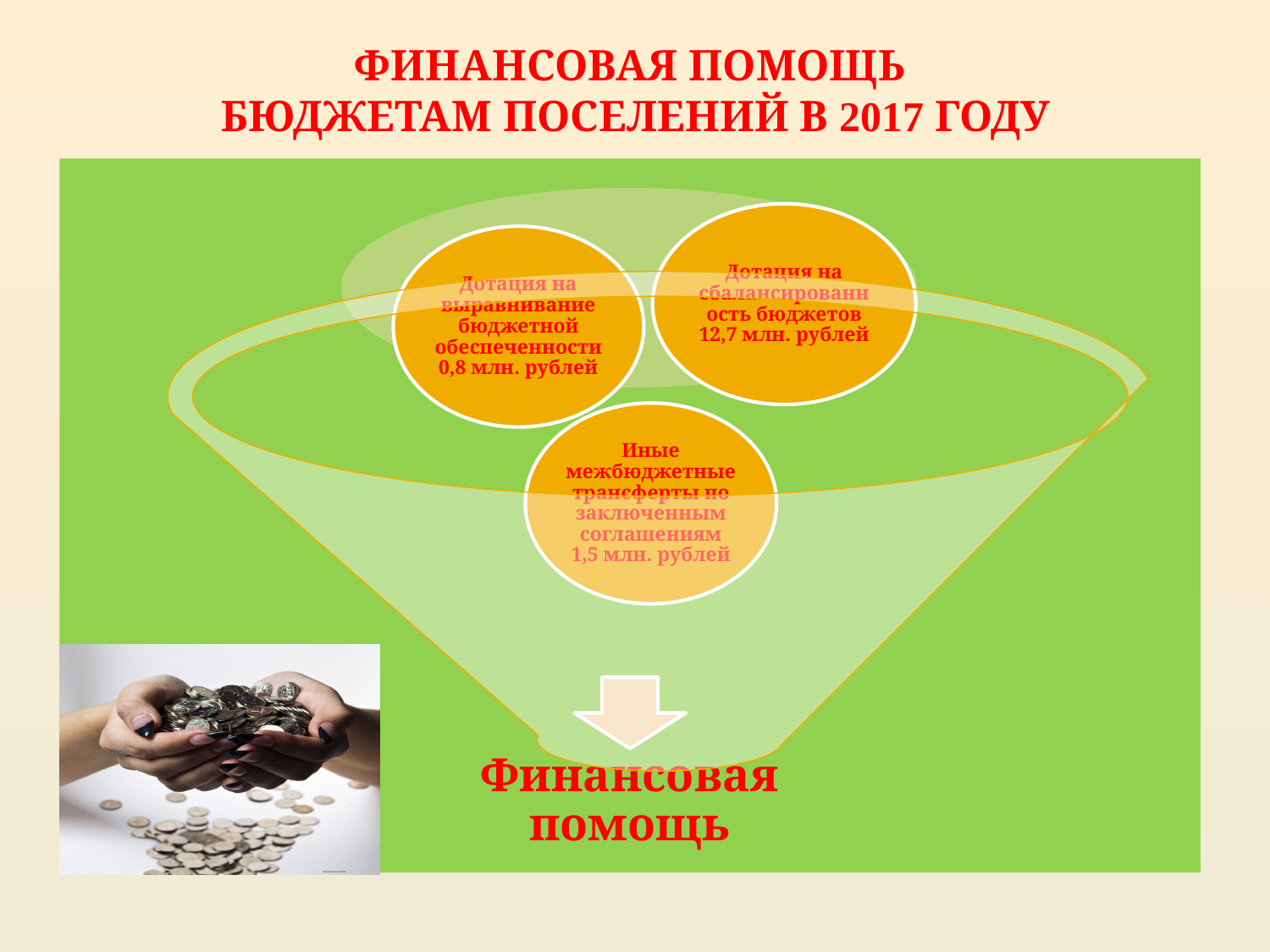
What is the value for "Дотация на сбалансированность бюджетов"? 12,7 млн. рублей Which component of financial assistance has the smallest value? Дотация на выравнивание бюджетной обеспеченности What is the value for "Дотация на выравнивание бюджетной обеспеченности"? 0,8 млн. рублей Which is larger: "Иные межбюджетные трансферты по заключенным соглашениям" or "Дотация на выравнивание бюджетной обеспеченности"? Иные межбюджетные трансферты по заключенным соглашениям What is the value for "Иные межбюджетные трансферты по заключенным соглашениям"? 1,5 млн. рублей What kind of diagram is shown on the slide? Funnel diagram What is the difference between "Дотация на сбалансированность бюджетов" and "Дотация на выравнивание бюджетной обеспеченности"? 11,9 млн. рублей What is the title of the slide? ФИНАНСОВАЯ ПОМОЩЬ БЮДЖЕТАМ ПОСЕЛЕНИЙ В 2017 ГОДУ Which component of financial assistance has the largest value? Дотация на сбалансированность бюджетов What is the difference between "Иные межбюджетные трансферты по заключенным соглашениям" and "Дотация на выравнивание бюджетной обеспеченности"? 0,7 млн. рублей What is the total of the three components shown in the funnel? 15,0 млн. рублей How many components of financial assistance are shown in the funnel? 3